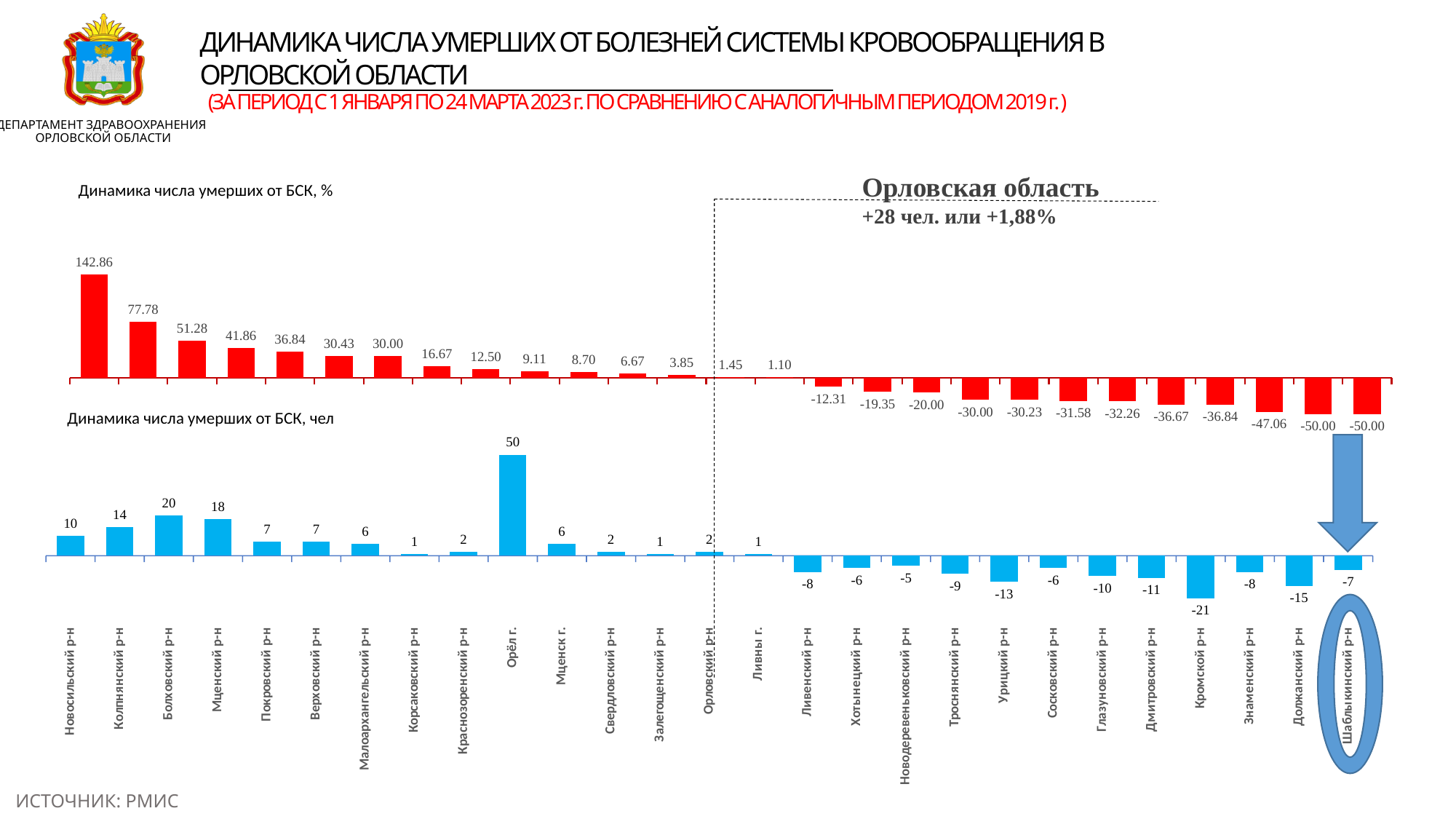
On the chart 'Динамика числа умерших от БСК, %', what is the value for Хотынецкий р-н? -19.35 On the chart 'Динамика числа умерших от БСК, %', what is the value for Новосильский р-н? 142.86 What colour are the bars on the chart 'Динамика числа умерших от БСК, чел'? Blue On the chart 'Динамика числа умерших от БСК, чел', what is the difference between the values for Болховский р-н and Мценский р-н? 2 On the chart 'Динамика числа умерших от БСК, чел', what is the value for Кромской р-н? -21 On the chart 'Динамика числа умерших от БСК, чел', which is larger: the value for Колпнянский р-н or the value for Новосильский р-н? Колпнянский р-н On the chart 'Динамика числа умерших от БСК, чел', which category has the lowest value? Кромской р-н On the chart 'Динамика числа умерших от БСК, чел', what is the value for Орёл г.? 50 On the chart 'Динамика числа умерших от БСК, %', which category has the highest value? Новосильский р-н On the chart 'Динамика числа умерших от БСК, %', what is the difference between the values for Новосильский р-н and Колпнянский р-н? 65.08 How many categories are shown on the chart 'Динамика числа умерших от БСК, чел'? 27 What kind of chart is 'Динамика числа умерших от БСК, %'? Bar chart